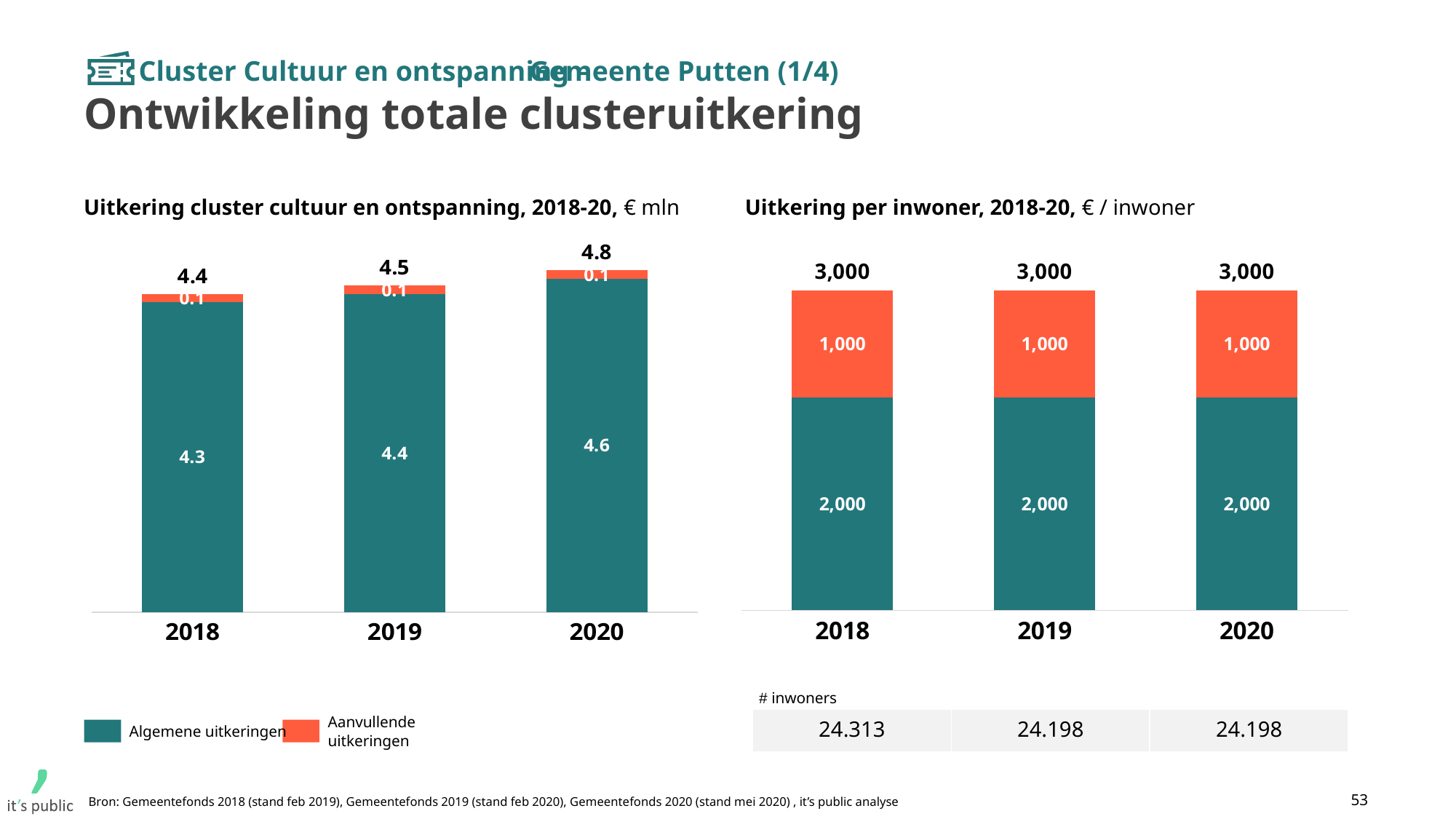
In the left chart (Uitkering cluster cultuur en ontspanning), what is the difference between Algemene uitkeringen in 2020 and in 2018? 0.3 In the right chart (Uitkering per inwoner), what is the total of the stacked bar for 2018? 3,000 In the right chart (Uitkering per inwoner), which is larger in 2020: Algemene uitkeringen or Aanvullende uitkeringen? Algemene uitkeringen How many series does the legend list for the charts on this slide? 2 In the right chart (Uitkering per inwoner), what is the value of Algemene uitkeringen for 2019? 2,000 In the left chart (Uitkering cluster cultuur en ontspanning), which year has the highest total uitkering? 2020 In the left chart (Uitkering cluster cultuur en ontspanning), which year has the lowest total uitkering? 2018 In the left chart (Uitkering cluster cultuur en ontspanning), do the total values rise or fall from 2018 to 2020? rise In the left chart (Uitkering cluster cultuur en ontspanning), what is the value of Aanvullende uitkeringen for 2019? 0.1 In the left chart (Uitkering cluster cultuur en ontspanning), what is the total of the stacked bar for 2020? 4.8 How many years are shown on the x axis of the left chart (Uitkering cluster cultuur en ontspanning)? 3 In the left chart (Uitkering cluster cultuur en ontspanning), what is the value of Algemene uitkeringen for 2018? 4.3